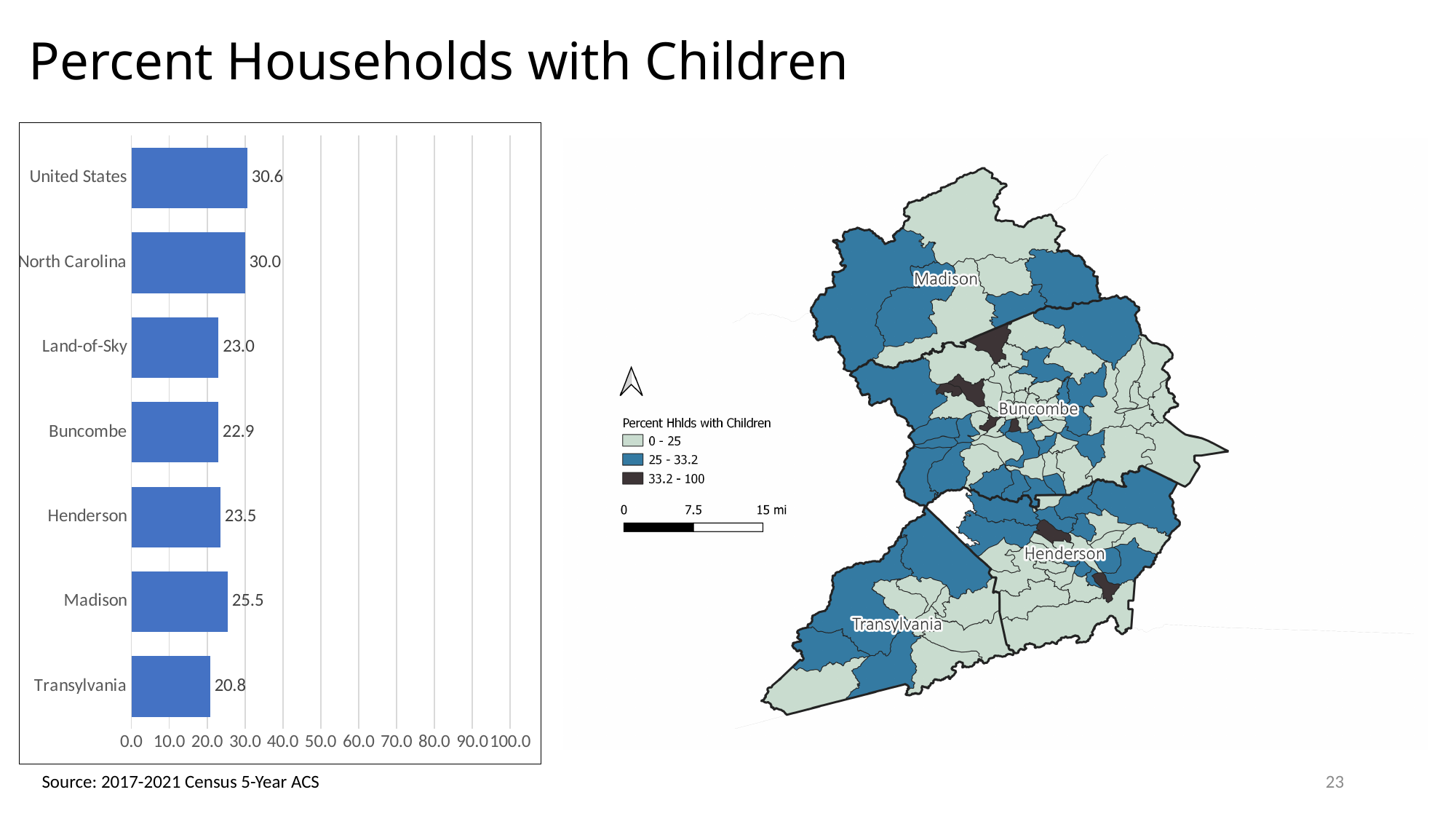
What is the value for Madison in the bar chart? 25.5 What is the value for Buncombe in the bar chart? 22.9 How many categories are shown in the bar chart? 7 What is the maximum value shown on the x axis of the bar chart? 100.0 Which is larger in the bar chart, the value for Henderson or the value for Buncombe? Henderson What is the difference between the values for North Carolina and Land-of-Sky in the bar chart? 7.0 What is the difference between the values for Madison and Transylvania in the bar chart? 4.7 What kind of chart is on the left of the slide? bar chart Which category has the highest value in the bar chart? United States Which category has the lowest value in the bar chart? Transylvania What is the value for the United States in the bar chart? 30.6 Is the value for Madison in the bar chart greater or less than 30.0? less